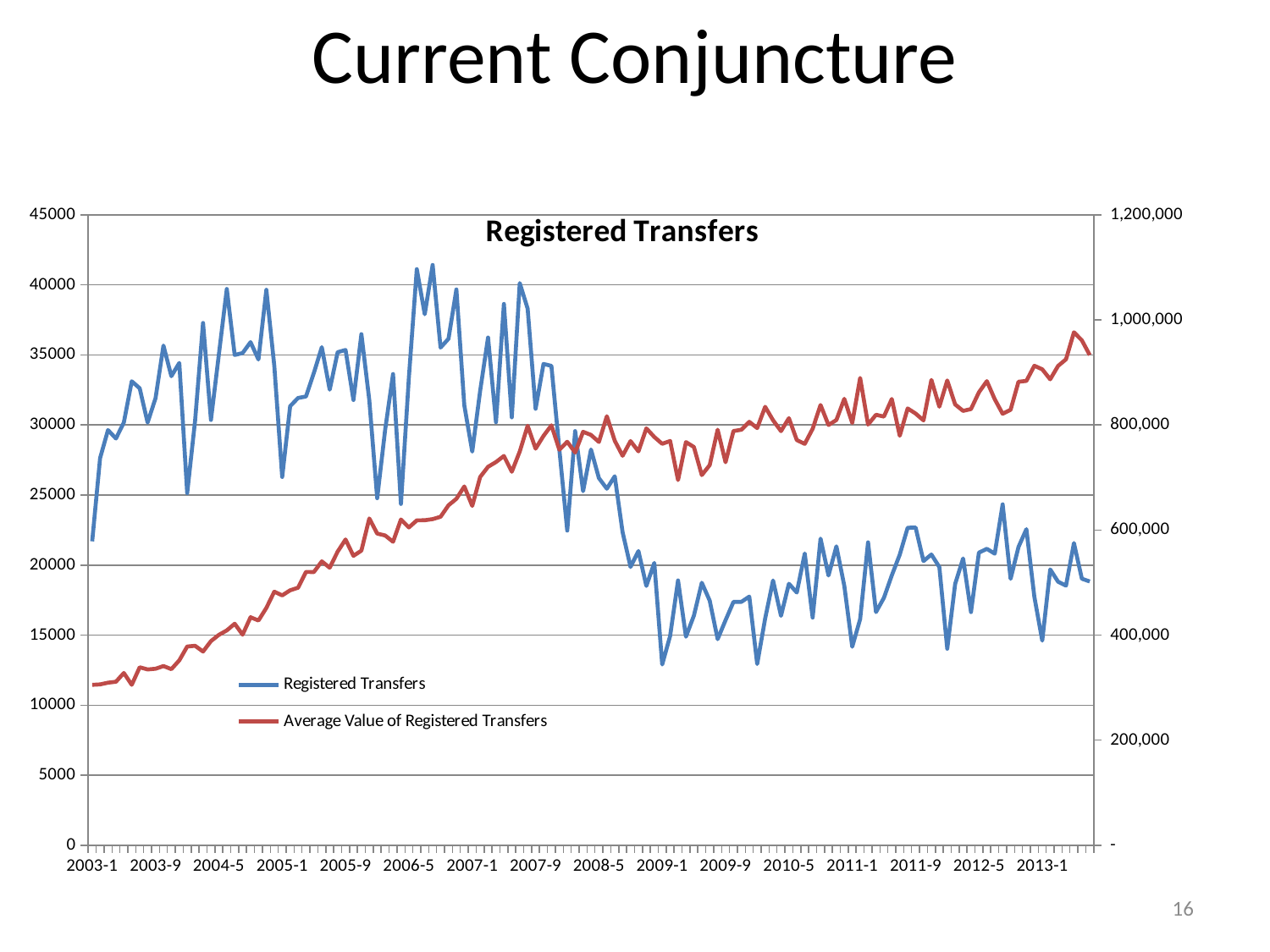
Is the value for Average Value of Registered Transfers at 2003-1 greater or less than 400,000? less Is the value for Registered Transfers at 2009-1 greater or less than 15000? less Does the Registered Transfers series generally rise or fall between 2007-9 and 2009-1? fall Does the Average Value of Registered Transfers series generally rise or fall from 2003-1 to 2013? rise What kind of chart is shown on the slide? line chart Is the value for Average Value of Registered Transfers at 2013-1 greater or less than 800,000? greater Which colour is used for the Average Value of Registered Transfers series? red How many date labels are shown on the x axis of the chart? 16 What is the title of the chart? Registered Transfers How many series does the legend of the chart list? 2